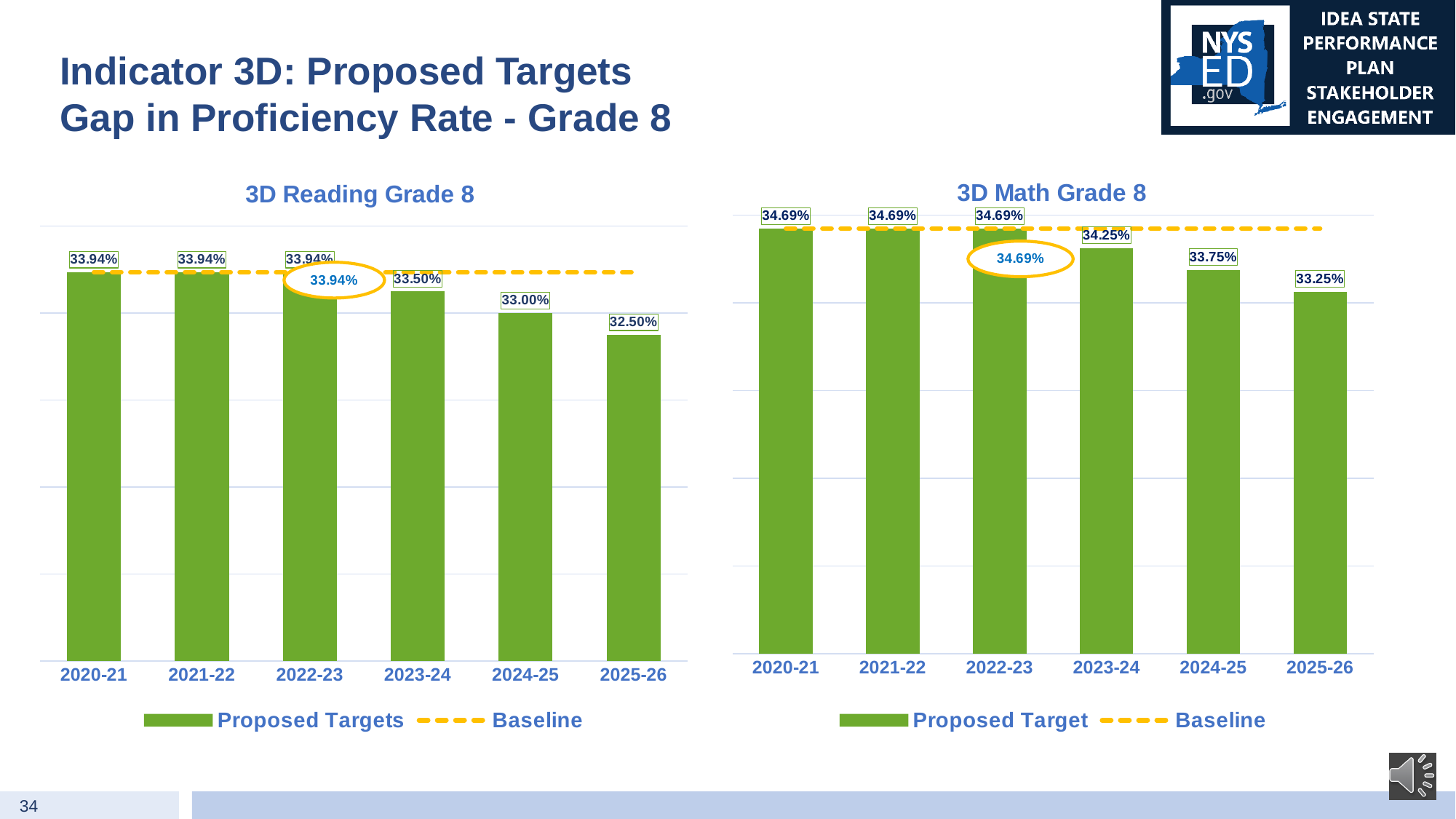
In the 3D Math Grade 8 chart, do the proposed targets rise or fall from 2022-23 to 2025-26? Fall In the 3D Math Grade 8 chart, which is larger, the proposed target for 2022-23 or for 2023-24? 2022-23 In the 3D Math Grade 8 chart, what is the difference between the 2023-24 and 2024-25 proposed targets? 0.50% What is the title of the chart on the right side of the slide? 3D Math Grade 8 What kind of chart is the 3D Reading Grade 8 chart? Combination bar and line chart In the 3D Reading Grade 8 chart, what is the proposed target for 2023-24? 33.50% In the 3D Reading Grade 8 chart, what is the difference between the 2020-21 and 2025-26 proposed targets? 1.44% How many years are shown on the x axis of the 3D Reading Grade 8 chart? 6 In the 3D Math Grade 8 chart, what is the proposed target for 2025-26? 33.25% How many series does the legend of the 3D Math Grade 8 chart list? 2 In the 3D Reading Grade 8 chart, what is the baseline value shown in the circled label? 33.94% In the 3D Math Grade 8 chart, which year has the lowest proposed target? 2025-26